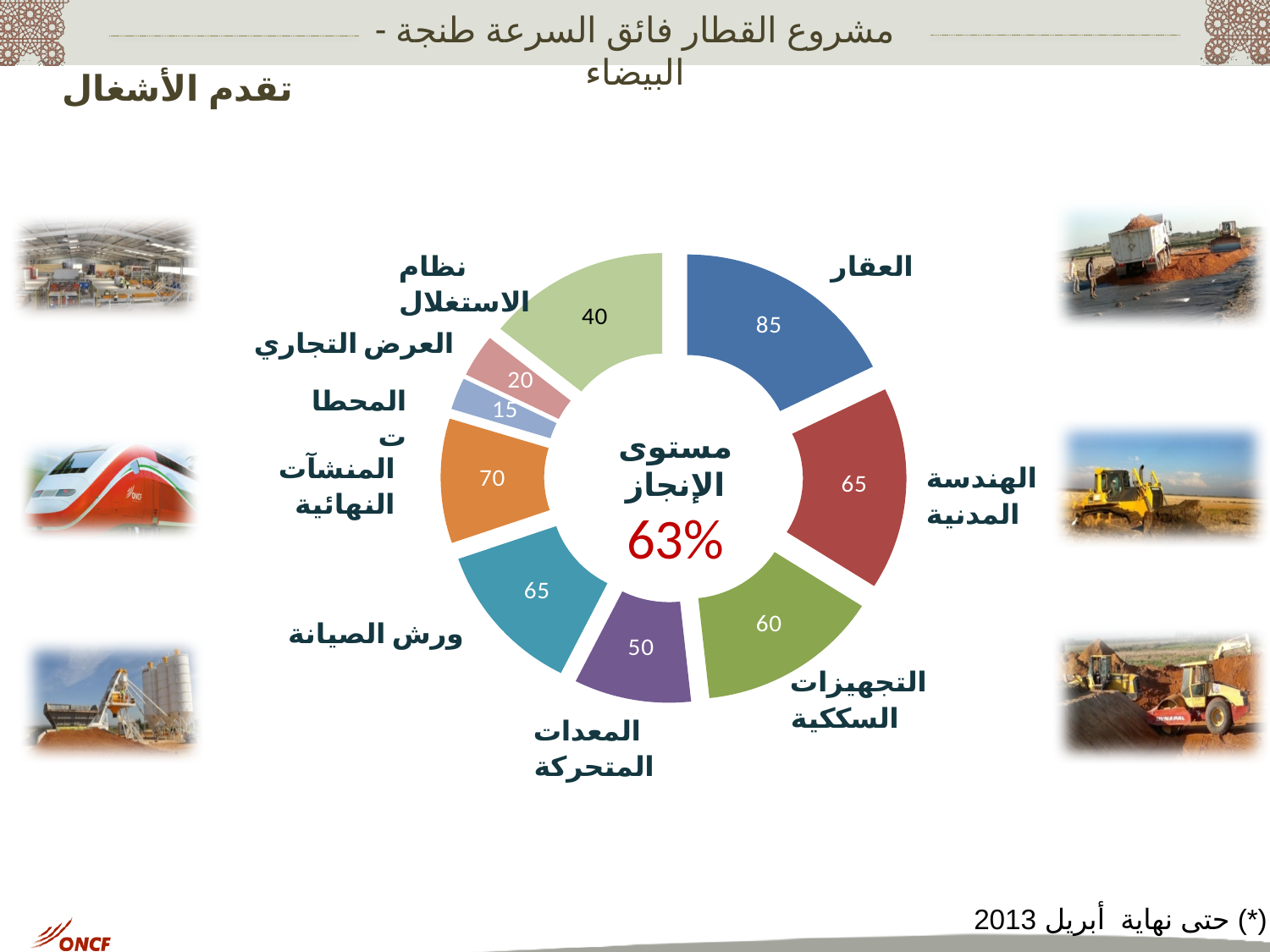
What value is shown for نظام الاستغلال in the doughnut chart? 40 Which category has the lowest value in the doughnut chart? المحطات What value is shown for المنشآت النهائية in the doughnut chart? 70 What is the difference between the values for العقار and المحطات? 70 What percentage is printed in the centre of the doughnut chart? 63% What value is shown for العقار in the doughnut chart? 85 What is the difference between the values for المنشآت النهائية and التجهيزات السككية? 10 How many categories are shown in the doughnut chart? 9 Which is larger, the value for العرض التجاري or the value for المحطات? العرض التجاري What kind of chart is shown on the slide? Doughnut chart What value is shown for المعدات المتحركة in the doughnut chart? 50 Which category has the highest value in the doughnut chart? العقار